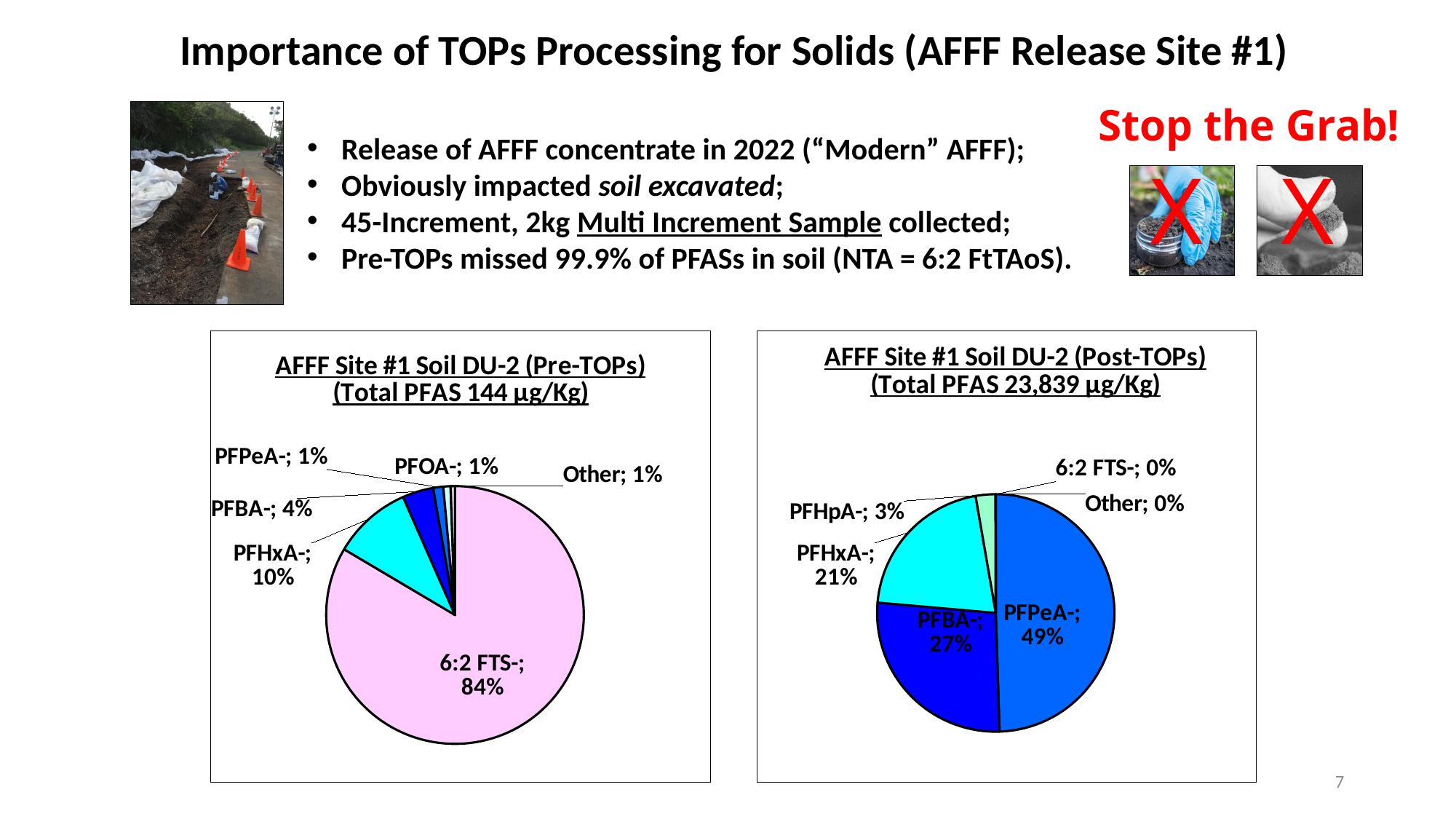
In the Pre-TOPs pie chart, what share does 6:2 FTS- have? 84% In the Post-TOPs pie chart, which category has the largest slice? PFPeA- What type of chart is used for AFFF Site #1 Soil DU-2 (Post-TOPs)? Pie chart In the Post-TOPs pie chart, what share does PFPeA- have? 49% In the Post-TOPs pie chart, what share does PFBA- have? 27% How many labelled slices does the Pre-TOPs pie chart have? 6 What total PFAS concentration is given in the title of the Post-TOPs chart? 23,839 µg/Kg In the Post-TOPs pie chart, which is larger, the share of PFHxA- or the share of PFHpA-? PFHxA- In the Pre-TOPs pie chart, which category has the largest slice? 6:2 FTS- In the Post-TOPs pie chart, what is the difference in share between PFPeA- and PFBA-? 22% In the Pre-TOPs pie chart, what is the difference in share between PFHxA- and PFBA-? 6%